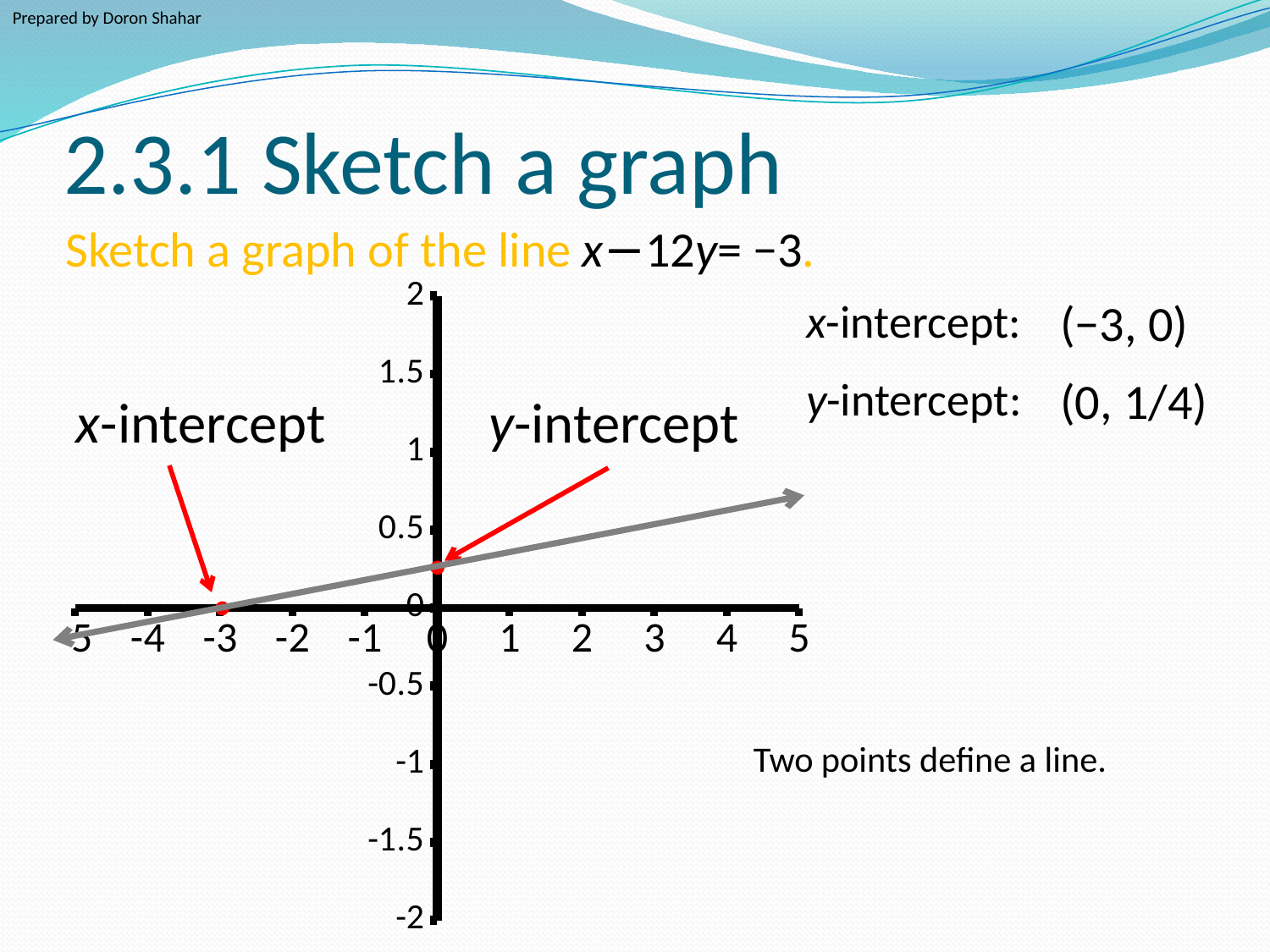
Is the value of y on the line at x = -5 greater or less than 0? less Is the value of y on the line at x = 5 greater or less than 1? less How many points are marked with red dots on the line? 2 What is the highest value labelled on the y axis? 2 What is the x-intercept of the line shown on the graph? (−3, 0) Which is larger: the y value of the line at x = 5 or at x = -5? at x = 5 What is the y-intercept of the line shown on the graph? (0, 1/4) What is the lowest value labelled on the x axis? -5 What kind of chart is shown on the slide? line chart Which equation is the graphed line a sketch of? x − 12y = −3 Is the value of y on the line at x = 5 greater or less than 0.5? greater Does the line rise or fall as x increases from left to right? rise